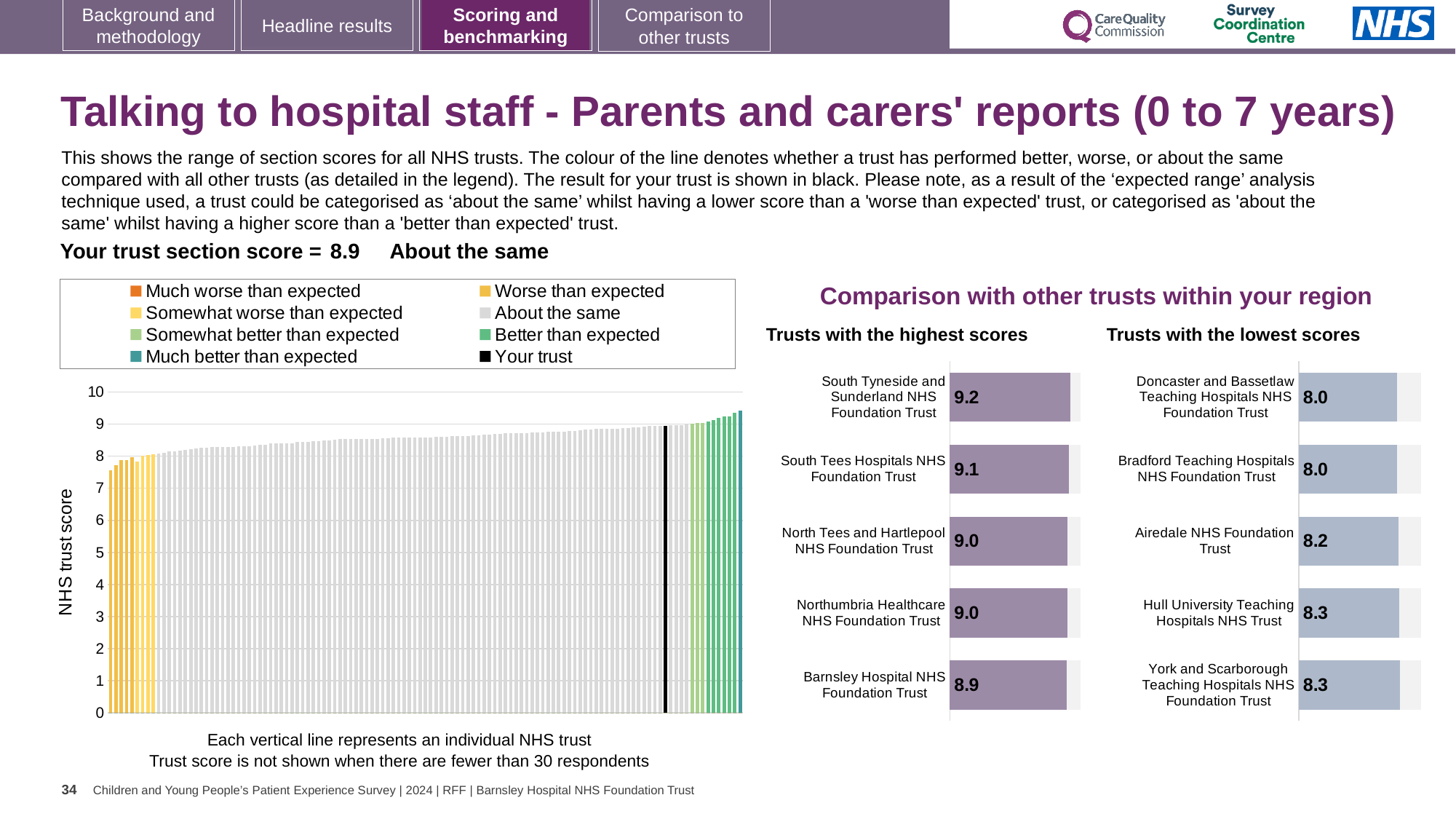
What type of chart is the large chart on the left showing NHS trust scores? Bar chart In the 'Trusts with the lowest scores' chart, what is the score for Airedale NHS Foundation Trust? 8.2 In the 'Trusts with the lowest scores' chart, what is the difference between the scores of Airedale NHS Foundation Trust and Doncaster and Bassetlaw Teaching Hospitals NHS Foundation Trust? 0.2 How many entries does the legend of the large chart on the left list? 8 In the 'Trusts with the highest scores' chart, which trust has the highest score? South Tyneside and Sunderland NHS Foundation Trust In the 'Trusts with the highest scores' chart, what is the score for Barnsley Hospital NHS Foundation Trust? 8.9 In the large chart on the left, is the value for the lowest-scoring trust (the leftmost bar) greater or less than 8? less Which has the larger score: South Tees Hospitals NHS Foundation Trust in the highest scores chart, or Hull University Teaching Hospitals NHS Trust in the lowest scores chart? South Tees Hospitals NHS Foundation Trust In the 'Trusts with the lowest scores' chart, which trust has the highest score shown? Hull University Teaching Hospitals NHS Trust and York and Scarborough Teaching Hospitals NHS Foundation Trust (both 8.3) In the 'Trusts with the highest scores' chart, what is the difference between the scores of South Tyneside and Sunderland NHS Foundation Trust and Barnsley Hospital NHS Foundation Trust? 0.3 In the 'Trusts with the highest scores' chart, what is the score for South Tyneside and Sunderland NHS Foundation Trust? 9.2 How many trusts are listed in the 'Trusts with the highest scores' chart? 5